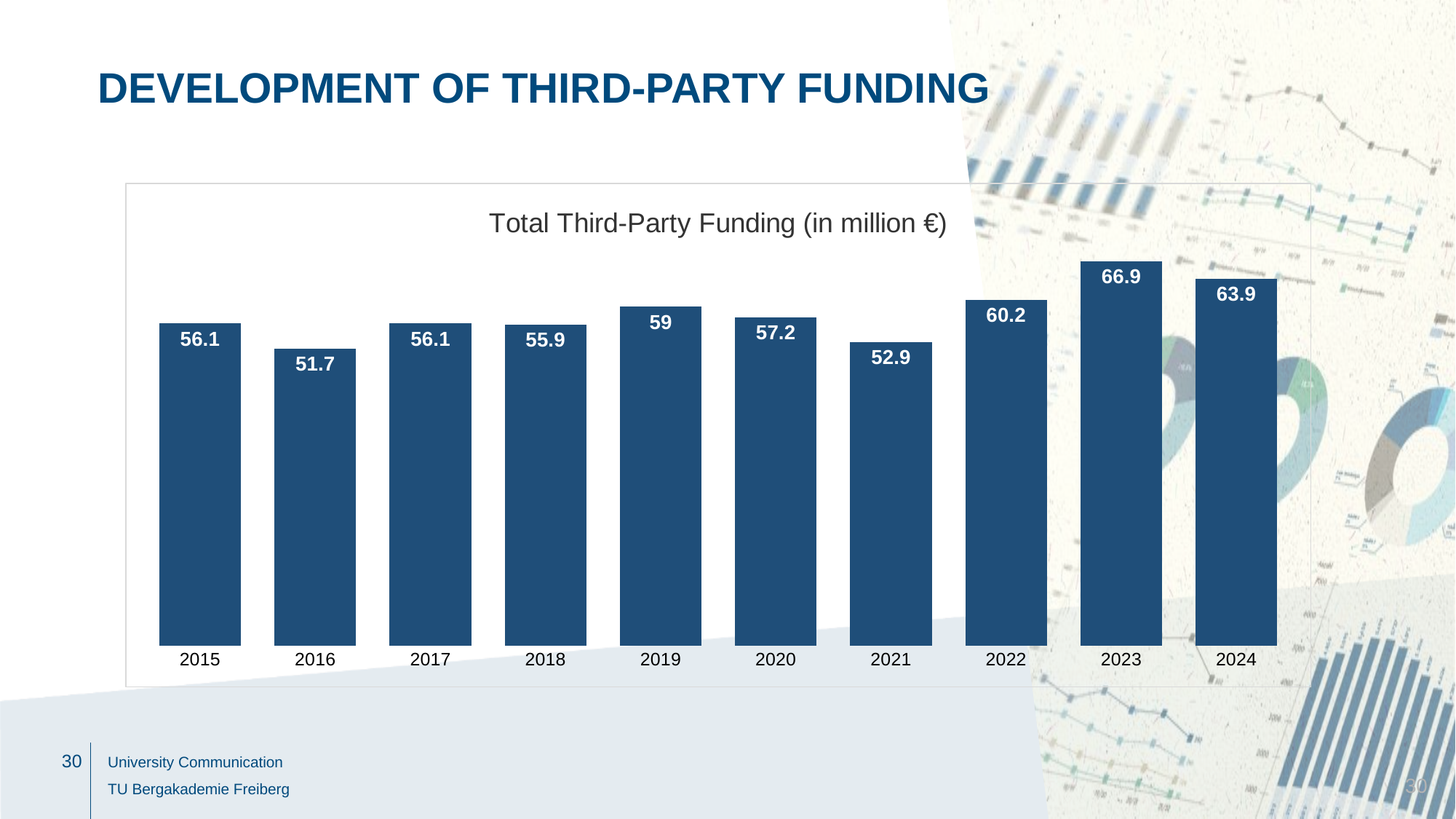
What is the difference in total third-party funding between 2023 and 2024? 3 What is the total third-party funding for 2019? 59 How many years are shown in the chart? 10 What is the total third-party funding for 2024? 63.9 Which year has the highest total third-party funding? 2023 What kind of chart is shown on the slide? Bar chart Which year has higher total third-party funding, 2020 or 2021? 2020 What is the difference in total third-party funding between 2022 and 2021? 7.3 Which year has the lowest total third-party funding? 2016 What is the title of the chart? Total Third-Party Funding (in million €) What is the total third-party funding for 2016? 51.7 Does the total third-party funding rise or fall from 2021 to 2023? Rise